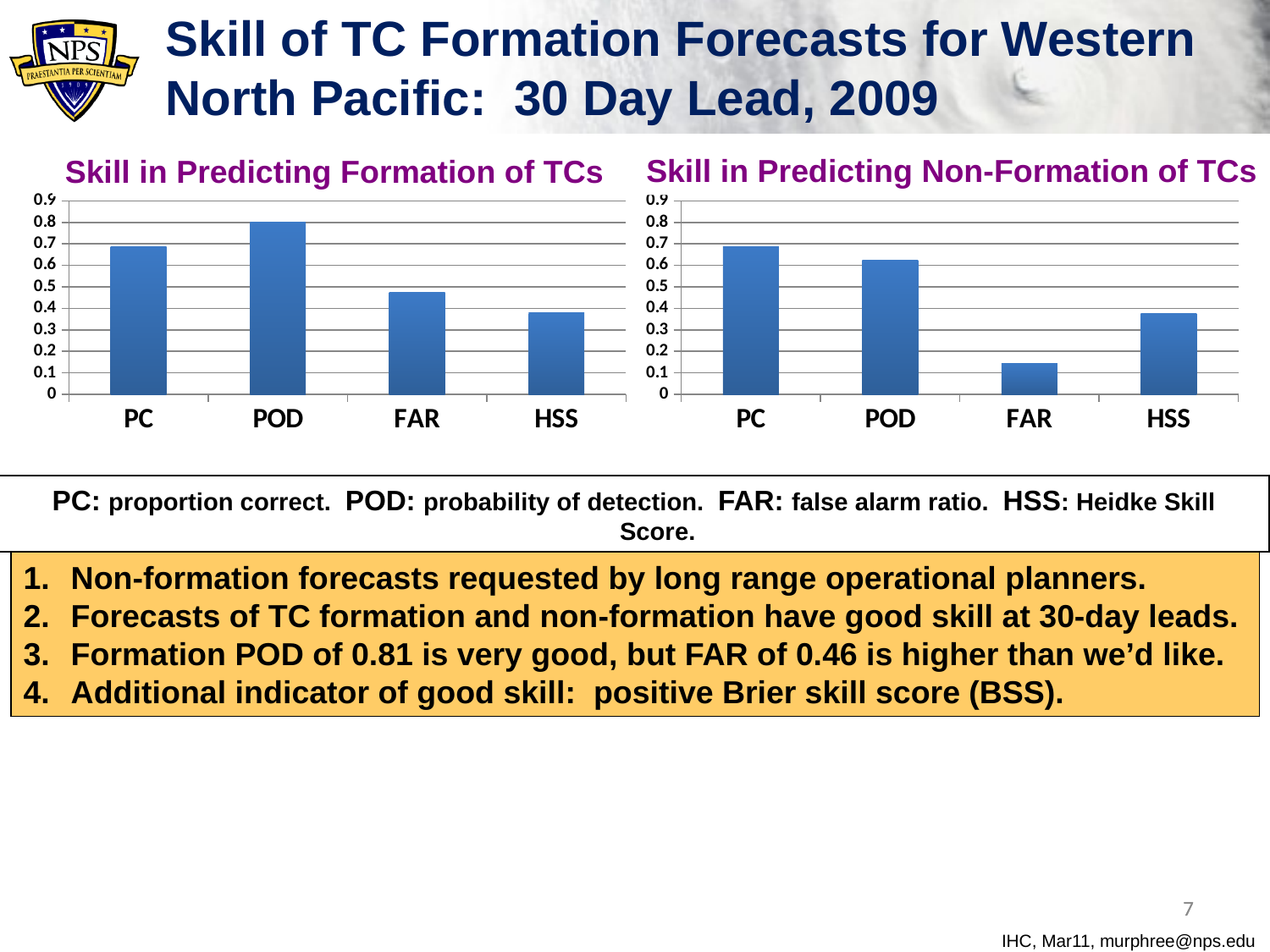
In the 'Skill in Predicting Non-Formation of TCs' chart, which is larger, PC or POD? PC In the 'Skill in Predicting Non-Formation of TCs' chart, is the value for HSS greater or less than 0.3? greater In the 'Skill in Predicting Non-Formation of TCs' chart, is the value for FAR greater or less than 0.2? less In the 'Skill in Predicting Formation of TCs' chart, is the value for PC greater or less than 0.6? greater In the 'Skill in Predicting Formation of TCs' chart, which category has the lowest value? HSS How many categories are shown on the 'Skill in Predicting Non-Formation of TCs' chart? 4 In the 'Skill in Predicting Non-Formation of TCs' chart, which category has the lowest value? FAR In the 'Skill in Predicting Non-Formation of TCs' chart, which category has the highest value? PC What is the title of the chart on the right side of the slide? Skill in Predicting Non-Formation of TCs In the 'Skill in Predicting Formation of TCs' chart, which category has the highest value? POD In the 'Skill in Predicting Formation of TCs' chart, which is larger, POD or FAR? POD What kind of chart is the 'Skill in Predicting Formation of TCs' chart? bar chart